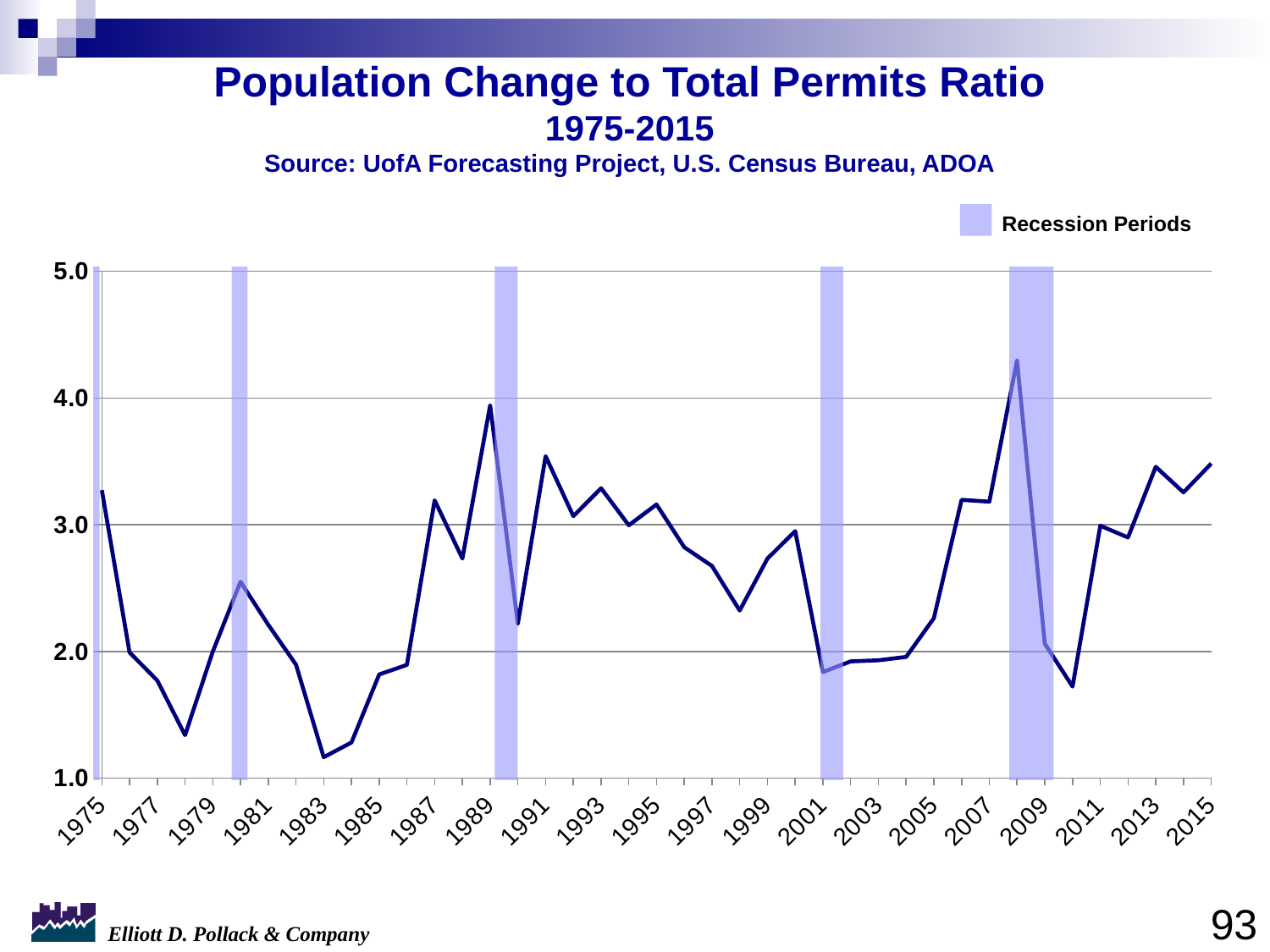
Is the value for 2008 greater or less than 4.0? greater Does the ratio rise or fall from 1975 to 1978? fall Which year has the larger ratio, 2008 or 1989? 2008 What does the shaded band in the legend represent? Recession Periods Is the value for 1975 greater or less than 3.0? greater Is the value for 1983 greater or less than 2.0? less How many shaded recession periods are marked on the chart? 5 In which year does the Population Change to Total Permits Ratio reach its highest value? 2008 What kind of chart is shown on the slide? line chart In which year does the Population Change to Total Permits Ratio reach its lowest value? 1983